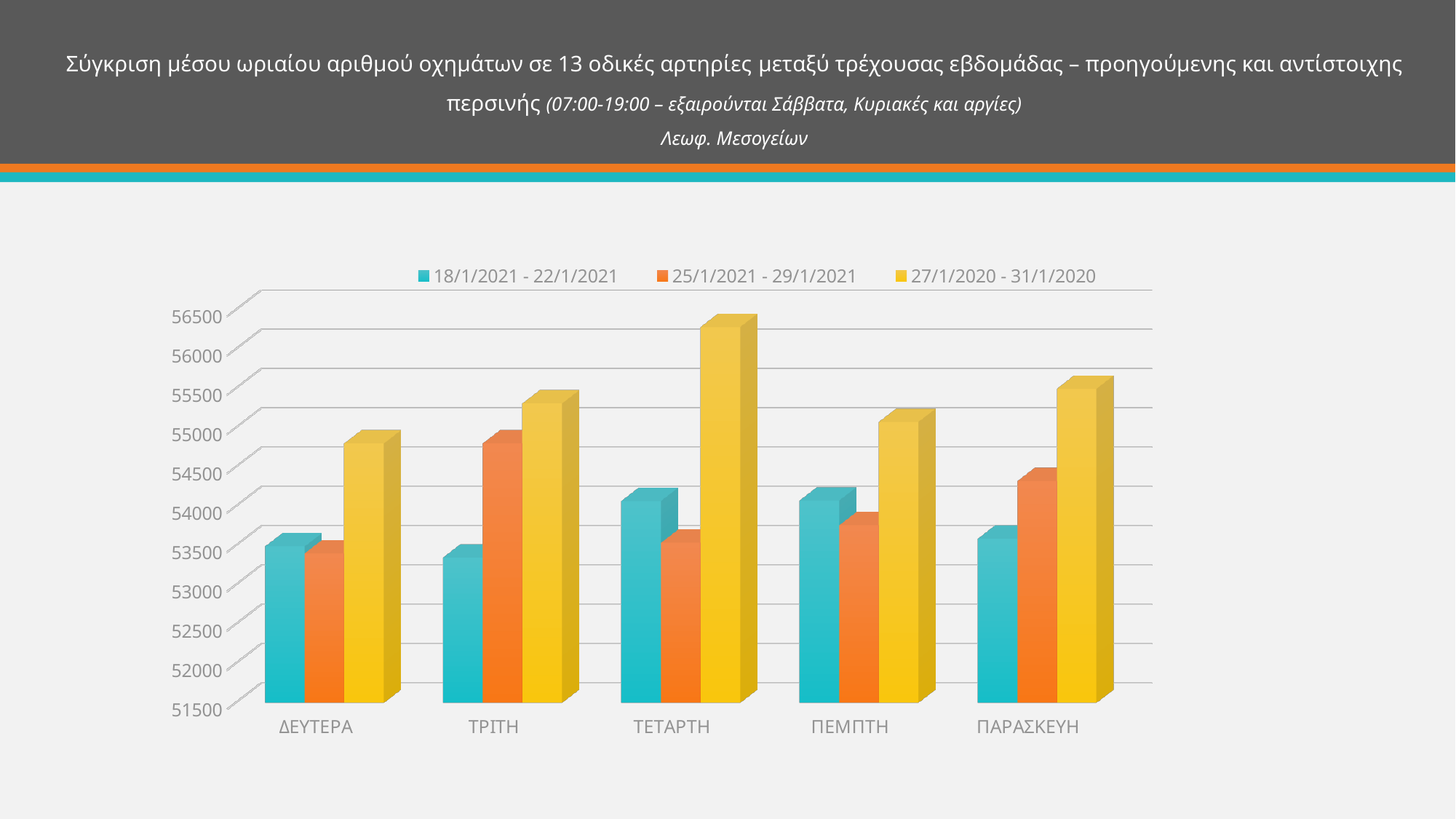
Is the value for ΠΑΡΑΣΚΕΥΗ in the 27/1/2020 - 31/1/2020 series greater or less than 55000? greater Which series is shown in yellow in the chart legend? 27/1/2020 - 31/1/2020 What kind of chart is shown on the slide? bar chart How many categories (days) are shown on the x axis of the chart? 5 How many series does the chart legend list? 3 Is the value for ΤΕΤΑΡΤΗ in the 27/1/2020 - 31/1/2020 series greater or less than 56000? greater Which day has the highest value for the 25/1/2021 - 29/1/2021 series? ΤΡΙΤΗ Which day has the highest value for the 27/1/2020 - 31/1/2020 series? ΤΕΤΑΡΤΗ Is the value for ΤΕΤΑΡΤΗ in the 25/1/2021 - 29/1/2021 series greater or less than 54000? less For ΤΡΙΤΗ, which series has the larger value: 18/1/2021 - 22/1/2021 or 25/1/2021 - 29/1/2021? 25/1/2021 - 29/1/2021 For ΤΕΤΑΡΤΗ, which series has the larger value: 18/1/2021 - 22/1/2021 or 25/1/2021 - 29/1/2021? 18/1/2021 - 22/1/2021